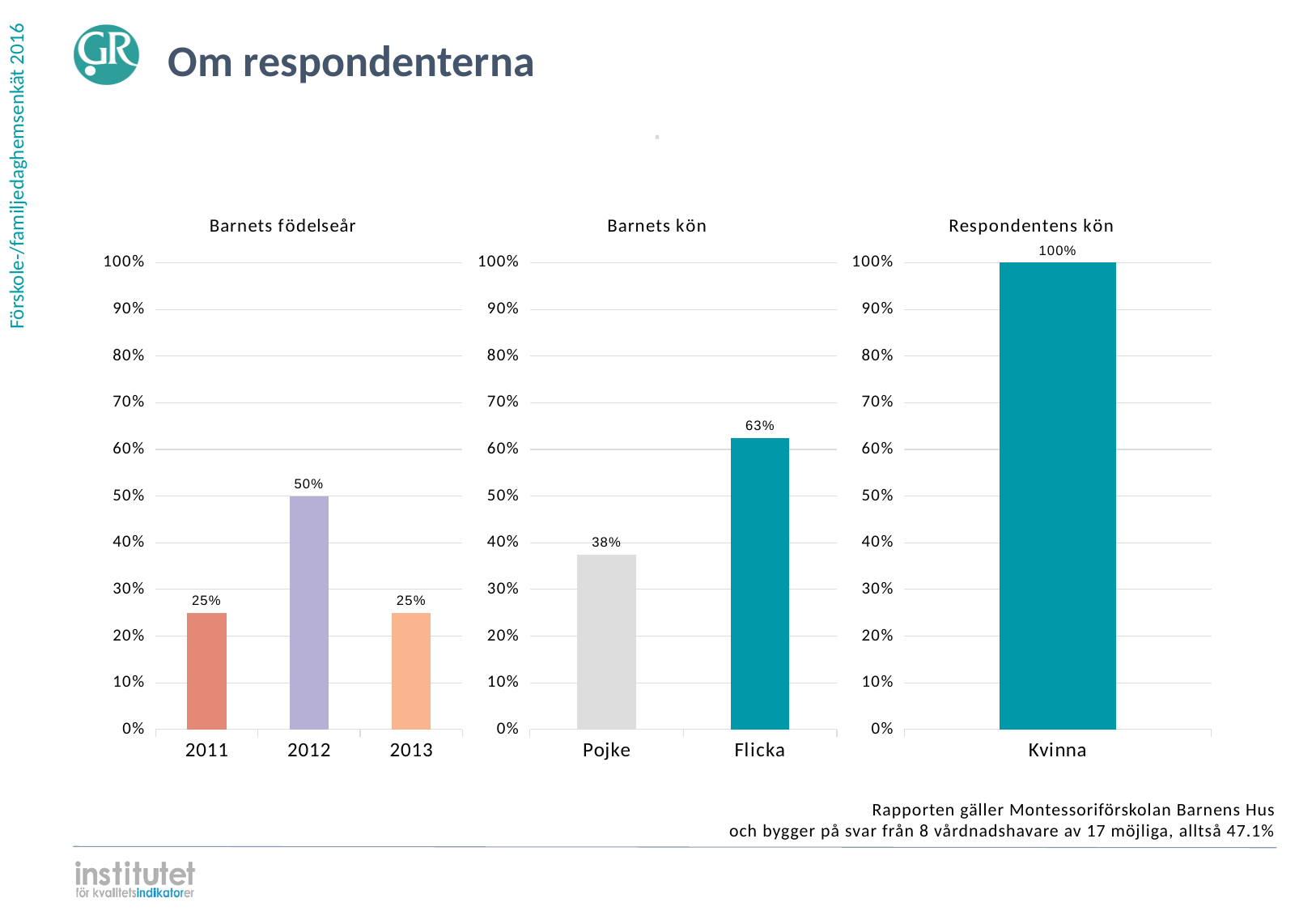
In the 'Barnets födelseår' chart, how many categories are shown on the x axis? 3 In the 'Barnets kön' chart, what is the value for Pojke? 38% In the 'Respondentens kön' chart, how many categories are shown on the x axis? 1 In the 'Barnets födelseår' chart, what is the difference between the values for 2012 and 2011? 25% In the 'Barnets kön' chart, what is the value for Flicka? 63% In the 'Barnets födelseår' chart, is the value for 2013 greater or less than 30%? less What kind of chart is the 'Barnets kön' chart? Bar chart In the 'Barnets födelseår' chart, which year has the highest value? 2012 In the 'Respondentens kön' chart, what is the value for Kvinna? 100% In the 'Barnets kön' chart, what is the difference between the values for Flicka and Pojke? 25% In the 'Barnets födelseår' chart, what is the value for 2012? 50% In the 'Barnets kön' chart, which category is larger, Pojke or Flicka? Flicka